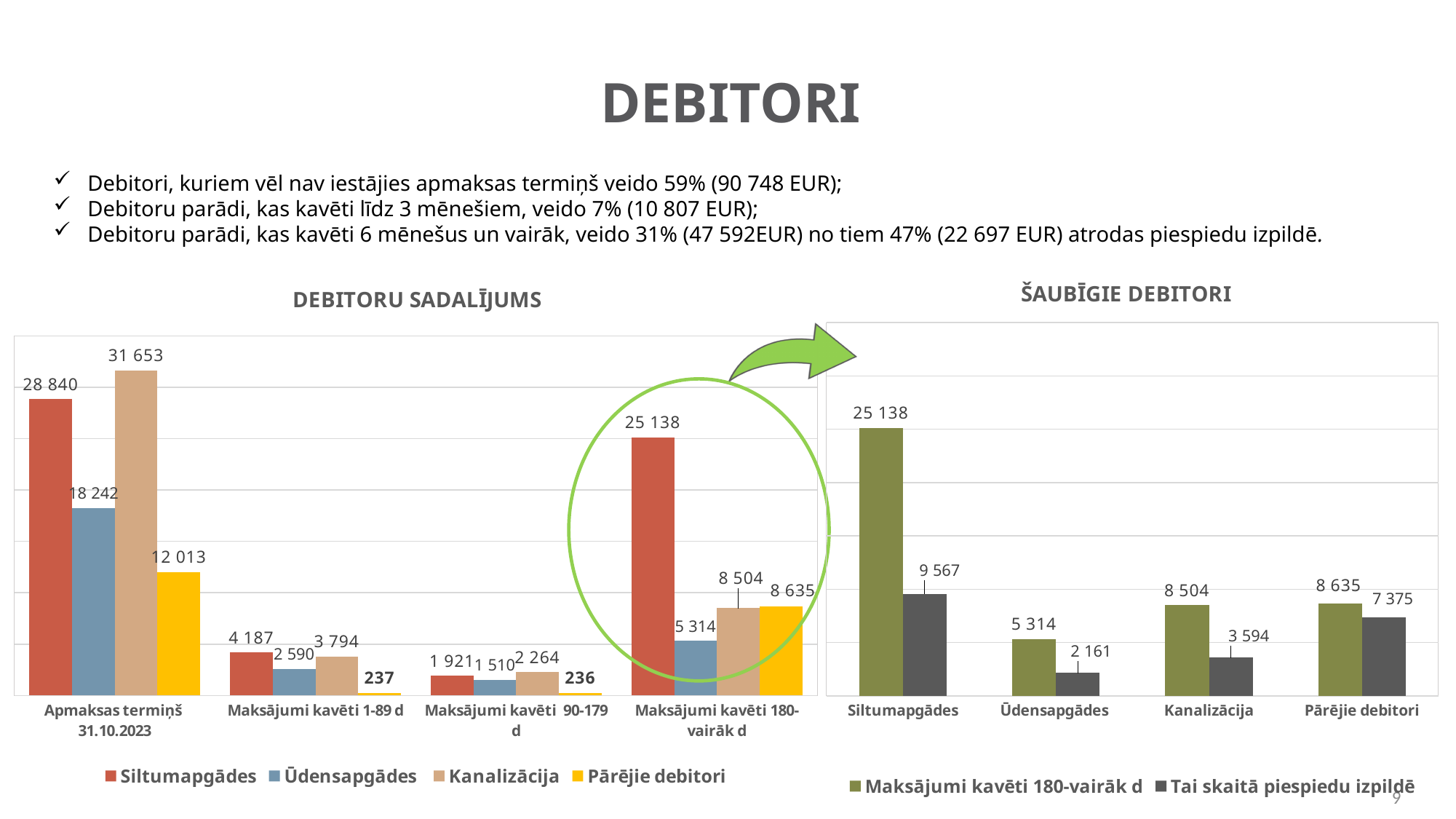
What kind of chart is the DEBITORU SADALĪJUMS chart? Bar chart In the ŠAUBĪGIE DEBITORI chart, what is the value of Maksājumi kavēti 180-vairāk d for Ūdensapgādes? 5 314 In the DEBITORU SADALĪJUMS chart, which series has the lowest value in the Maksājumi kavēti 90-179 d category? Pārējie debitori In the DEBITORU SADALĪJUMS chart, what is the value for Kanalizācija in the Apmaksas termiņš 31.10.2023 category? 31 653 In the DEBITORU SADALĪJUMS chart, what is the value for Pārējie debitori in the Maksājumi kavēti 1-89 d category? 237 In the ŠAUBĪGIE DEBITORI chart, what is the difference between Maksājumi kavēti 180-vairāk d and Tai skaitā piespiedu izpildē for Kanalizācija? 4 910 In the DEBITORU SADALĪJUMS chart, what is the difference between Siltumapgādes and Ūdensapgādes in the Apmaksas termiņš 31.10.2023 category? 10 598 In the DEBITORU SADALĪJUMS chart, which series has the highest value in the Maksājumi kavēti 180-vairāk d category? Siltumapgādes In the ŠAUBĪGIE DEBITORI chart, how many categories are shown on the x axis? 4 In the ŠAUBĪGIE DEBITORI chart, which category has the highest Tai skaitā piespiedu izpildē value? Siltumapgādes In the ŠAUBĪGIE DEBITORI chart, what is the value of Tai skaitā piespiedu izpildē for Siltumapgādes? 9 567 In the DEBITORU SADALĪJUMS chart, how many series does the legend list? 4